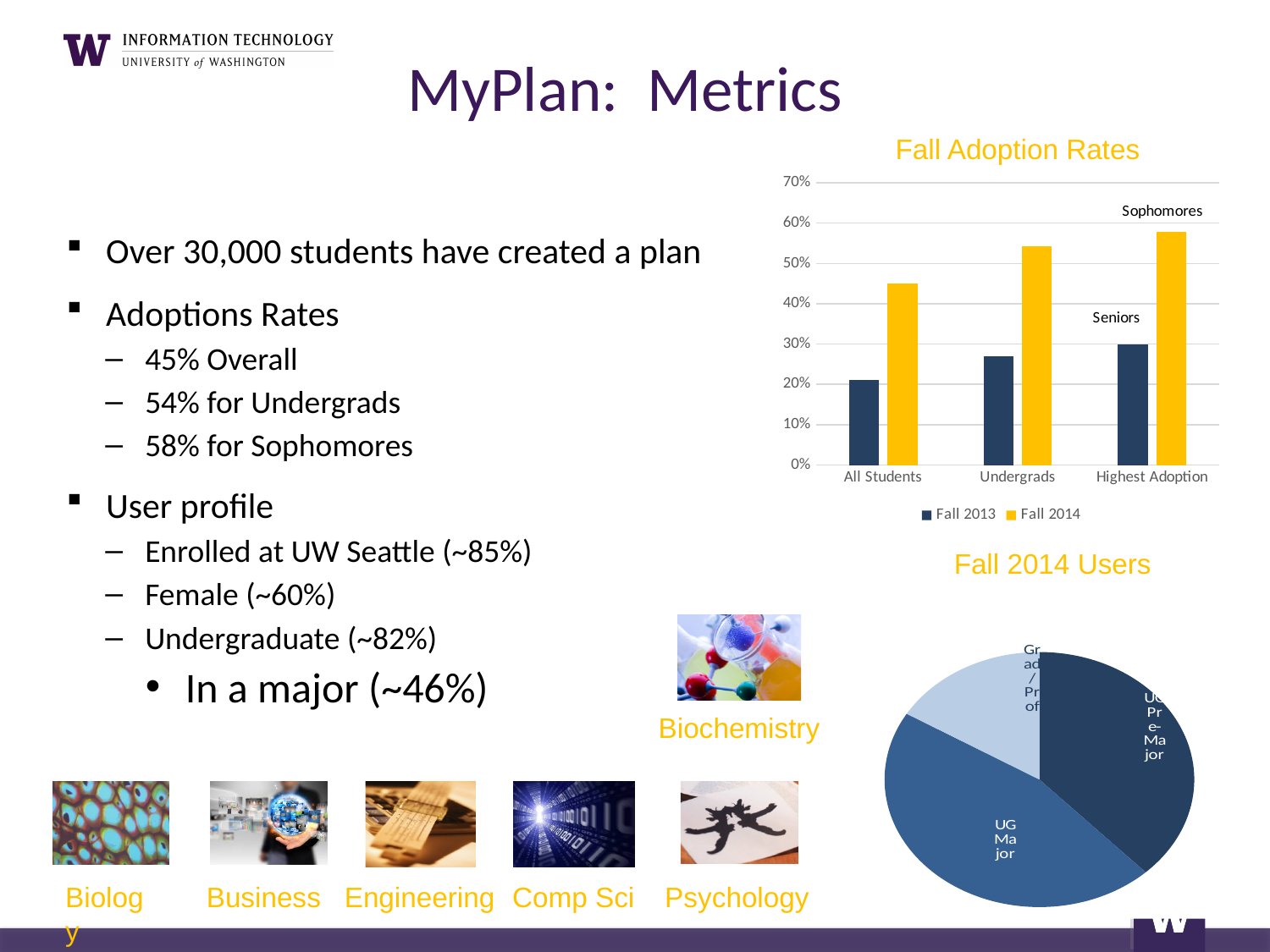
In the "Fall Adoption Rates" chart, which category has the highest Fall 2014 value? Highest Adoption In the "Fall 2014 Users" pie chart, how many slices are there? 3 In the "Fall Adoption Rates" chart, is the Fall 2014 value for All Students greater or less than 40%? greater In the "Fall Adoption Rates" chart, which category has the lowest Fall 2013 value? All Students In the "Fall Adoption Rates" chart, how many series does the legend list? 2 In the "Fall Adoption Rates" chart, how many categories are shown on the x axis? 3 In the "Fall Adoption Rates" chart, what are the two legend entries? Fall 2013 and Fall 2014 What kind of chart is the "Fall 2014 Users" chart? pie chart In the "Fall Adoption Rates" chart, is the Fall 2013 value for Undergrads greater or less than 30%? less What kind of chart is the "Fall Adoption Rates" chart? bar chart In the "Fall Adoption Rates" chart, which is larger for Undergrads: the Fall 2013 value or the Fall 2014 value? Fall 2014 In the "Fall Adoption Rates" chart, do the Fall 2014 values rise or fall from All Students to Highest Adoption? rise